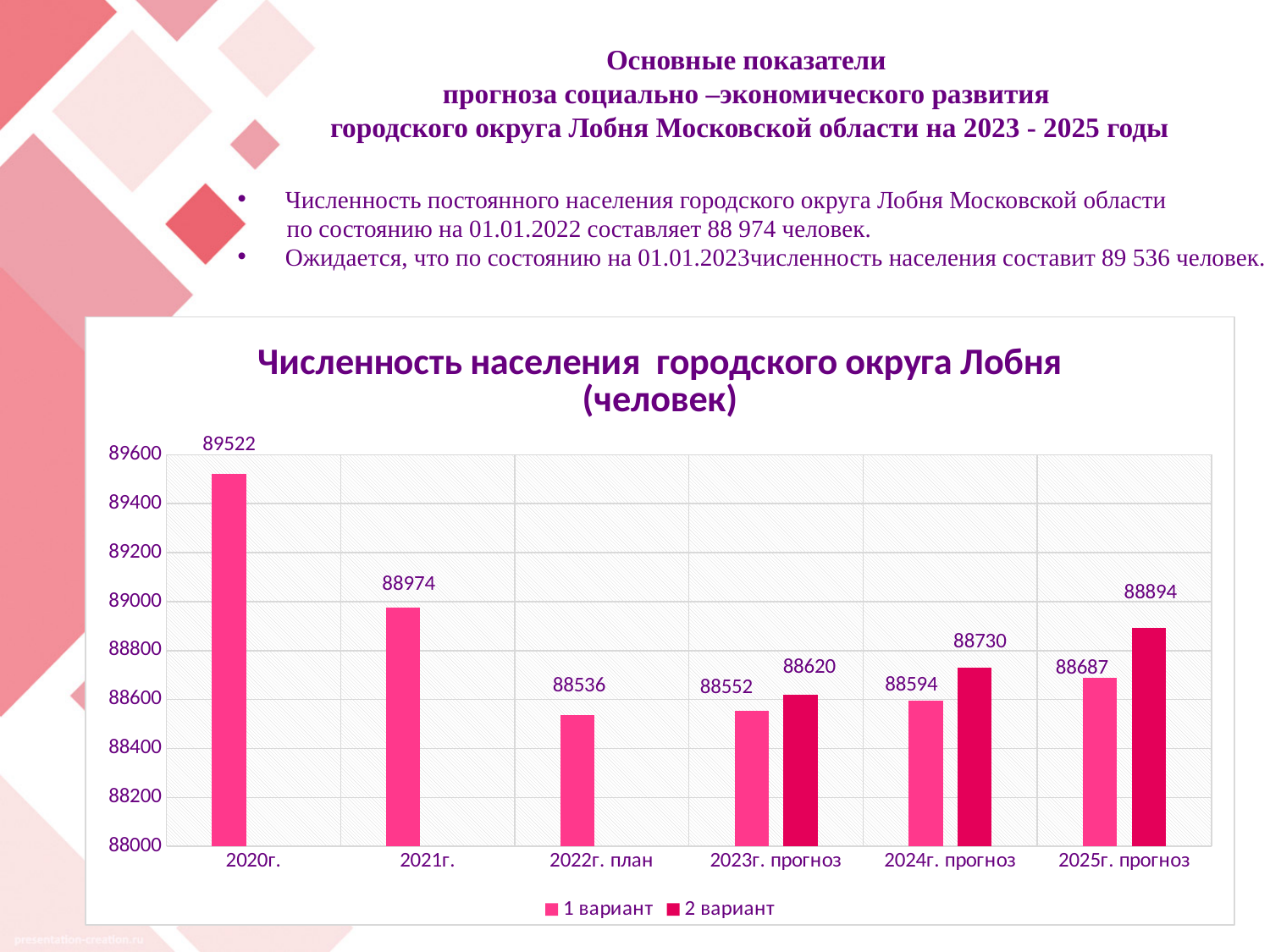
What is the value of the 1 вариант series for 2023г. прогноз? 88552 How many categories are shown on the x axis of the chart? 6 What is the value of the 2 вариант series for 2025г. прогноз? 88894 Which is larger: the 1 вариант value for 2025г. прогноз or the 2 вариант value for 2023г. прогноз? 1 вариант value for 2025г. прогноз What is the value for 2020г. in the chart? 89522 Which category has the highest value in the chart? 2020г. What is the difference between the values for 2020г. and 2021г.? 548 Which category has the lowest value in the 1 вариант series? 2022г. план Is the value for 2021г. greater or less than 89000? less What kind of chart is shown on the slide? bar chart What is the difference between the 2 вариант and 1 вариант values for 2024г. прогноз? 136 How many series does the legend list? 2